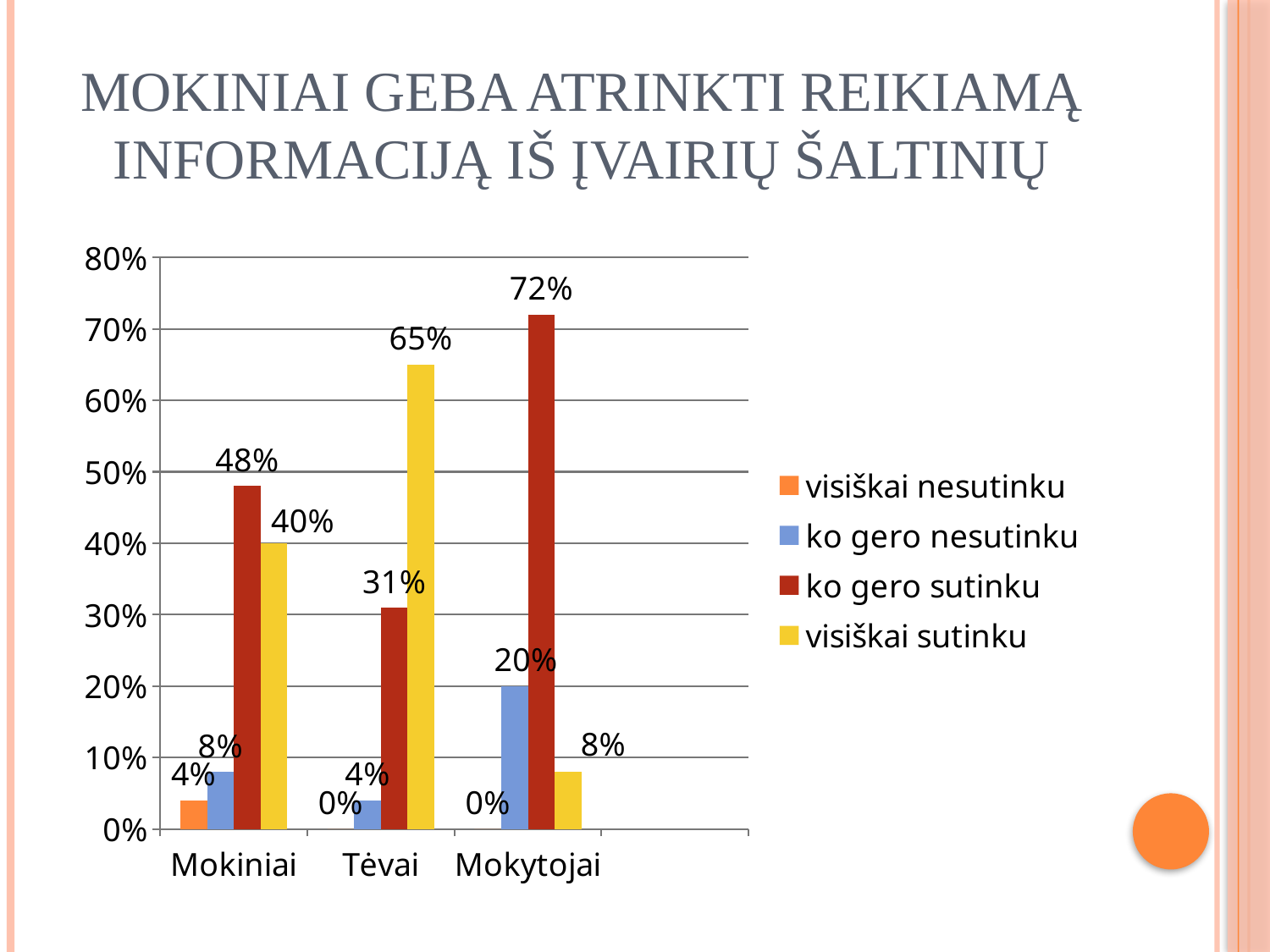
Which category has the lowest value for 'visiškai sutinku'? Mokytojai What is the value for 'ko gero nesutinku' in the Mokiniai category? 8% What is the value for 'visiškai sutinku' in the Tėvai category? 65% What kind of chart is shown on the slide? bar chart What is the value for 'visiškai nesutinku' in the Mokiniai category? 4% How many series does the legend list? 4 Which is larger in the Tėvai category: 'ko gero sutinku' or 'visiškai sutinku'? visiškai sutinku Which series is shown in yellow in the legend? visiškai sutinku What is the value for 'ko gero sutinku' in the Mokytojai category? 72% Which category has the highest value for 'ko gero sutinku'? Mokytojai What is the difference between 'ko gero sutinku' and 'visiškai sutinku' in the Mokiniai category? 8% How many categories are shown on the x axis? 3